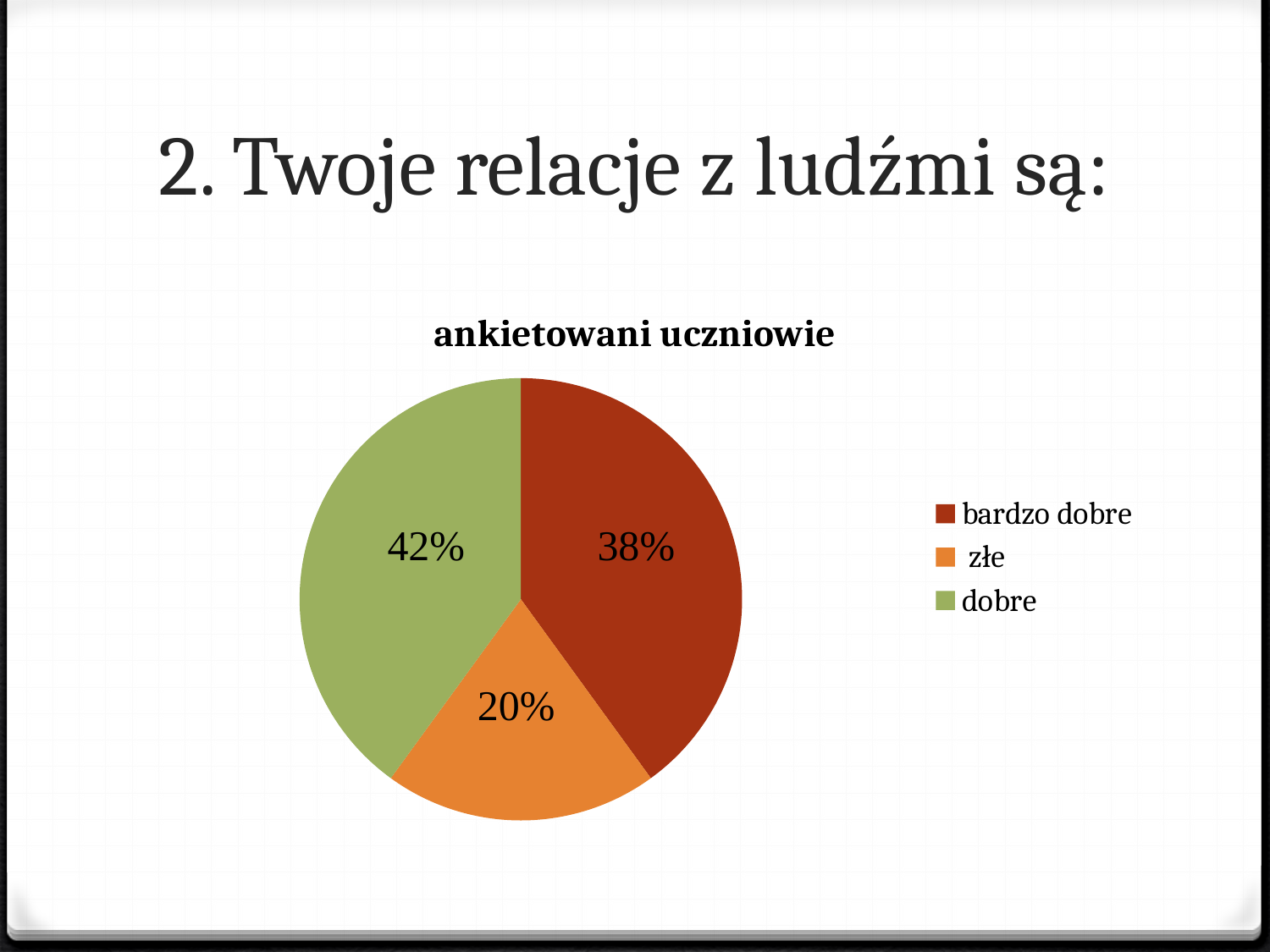
How many entries does the legend list? 3 What is the title of the chart? ankietowani uczniowie What share of the pie is labelled "dobre"? 42% Which category has the largest slice of the pie? dobre How many slices does the pie chart have? 3 What share of the pie is labelled "złe"? 20% What share of the pie is labelled "bardzo dobre"? 38% What kind of chart is shown on the slide? pie chart What colour is the "złe" slice in the pie chart? orange Which slice is larger, "bardzo dobre" or "złe"? bardzo dobre Which category has the smallest slice of the pie? złe What is the difference in percentage points between the "dobre" and "bardzo dobre" slices? 4